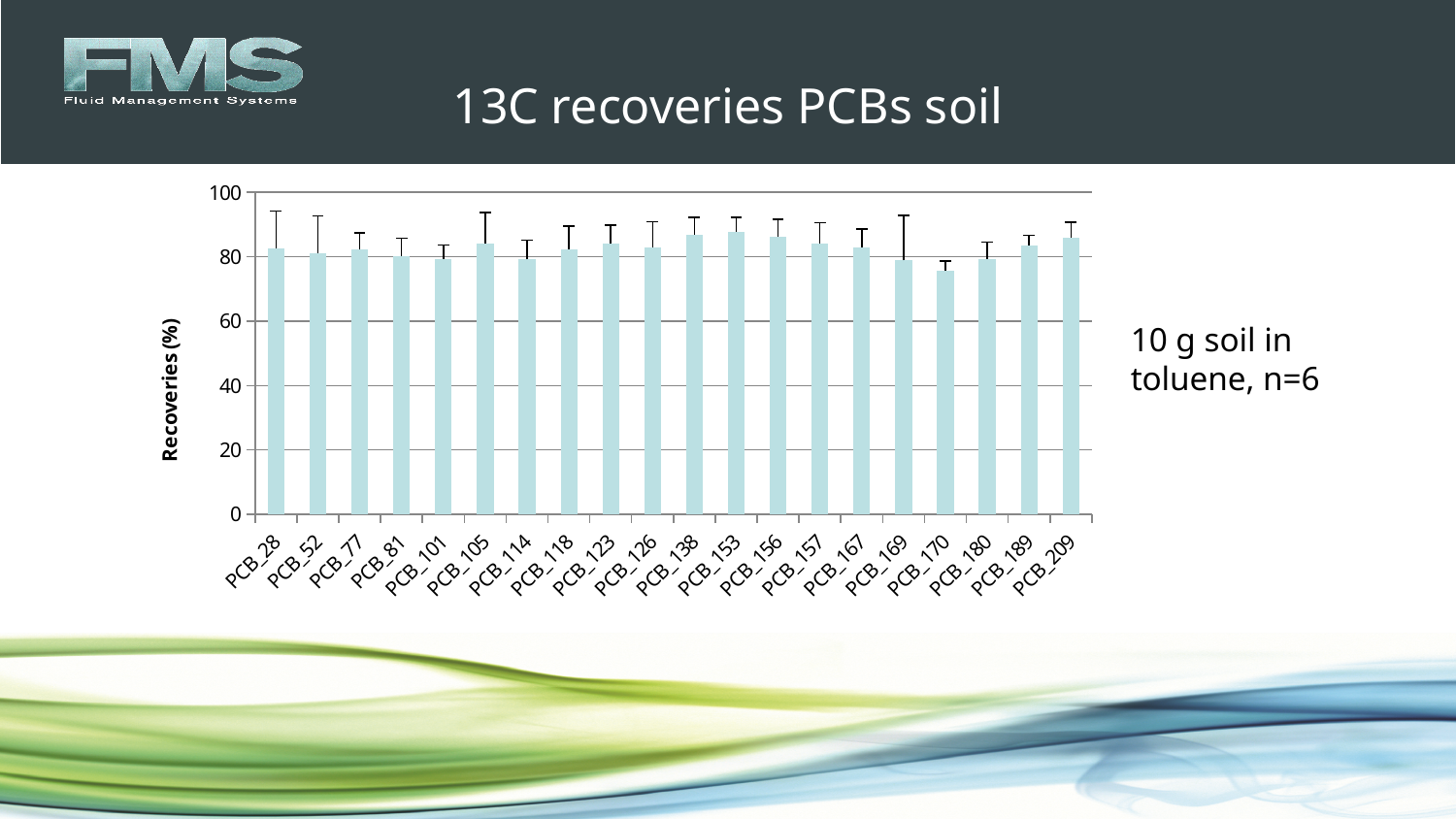
Is the recovery for PCB_153 greater or less than 80? greater Which PCB congener has the lowest recovery? PCB_170 How many PCB congeners are plotted on the x axis? 20 What kind of chart is shown on the slide? bar chart What is the label of the vertical axis? Recoveries (%) Is the recovery for PCB_28 greater or less than 60? greater Is the recovery for PCB_170 greater or less than 80? less Which has the higher recovery, PCB_153 or PCB_170? PCB_153 What is the title of the chart? 13C recoveries PCBs soil Which has the higher recovery, PCB_138 or PCB_101? PCB_138